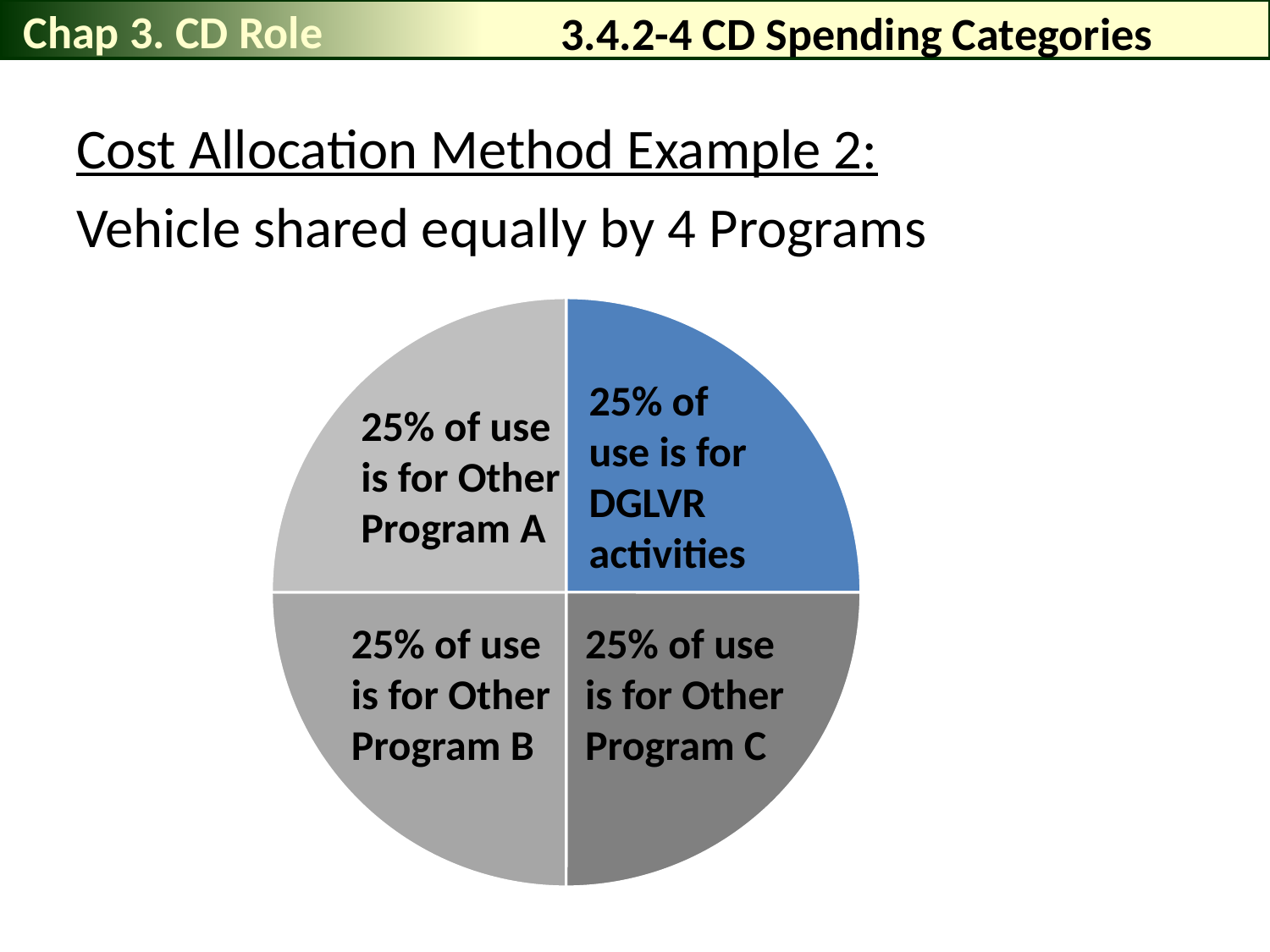
Is the share of use for DGLVR activities greater or less than 50%? less According to the slide text, how many programs share the vehicle equally? 4 What kind of chart is shown on the slide? pie chart Which slice of the pie chart is coloured blue? 25% of use is for DGLVR activities Are all four slices of the pie chart equal in size? yes What share of use is for Other Program B? 25% How many slices does the pie chart have? 4 What share of use is for DGLVR activities? 25% What is the combined share of use for Other Program A, B and C? 75% What is the difference between the share for DGLVR activities and the share for Other Program B? 0% What share of use is for Other Program A? 25% What share of use is for Other Program C? 25%